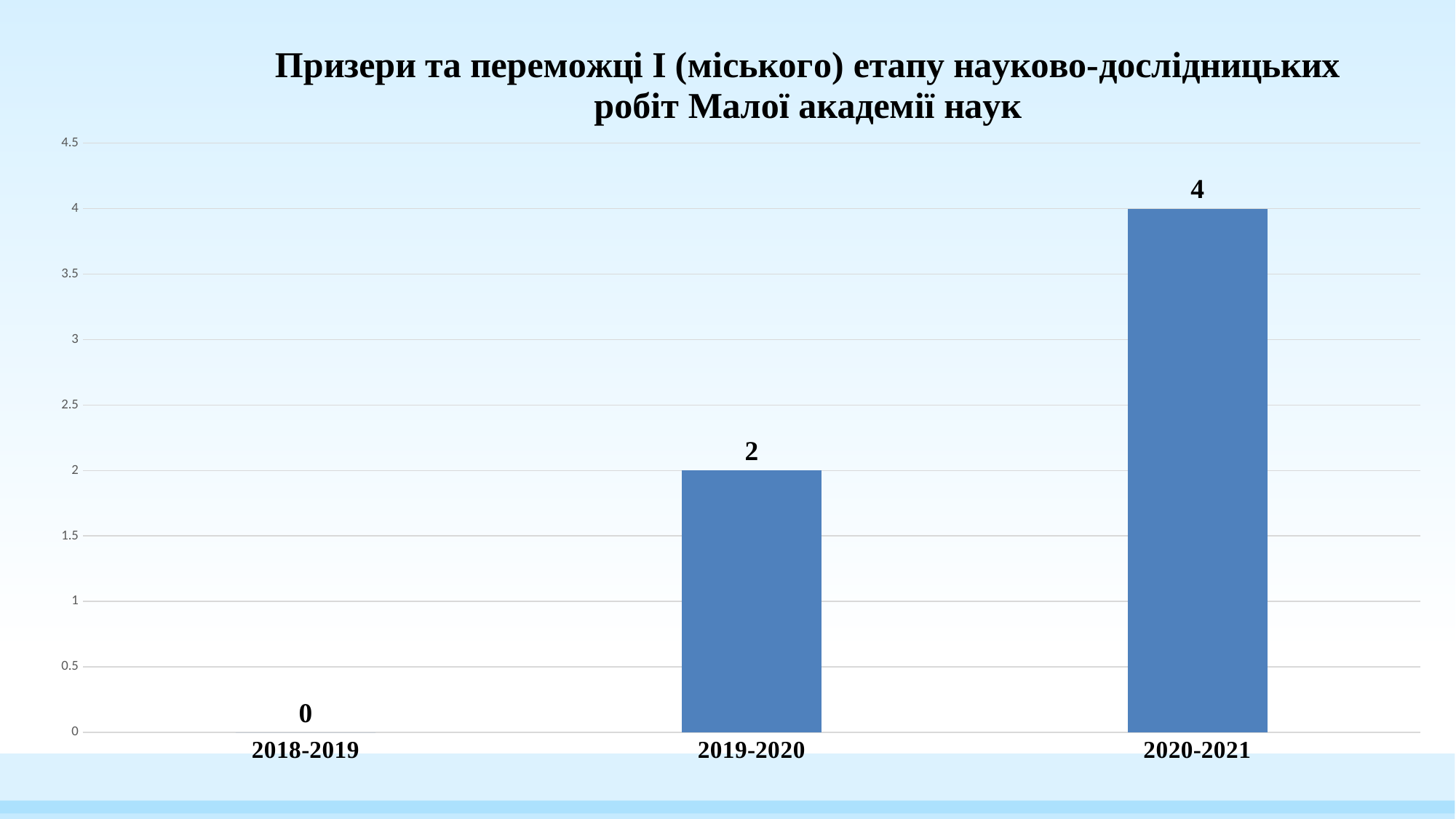
Which is larger, the value for 2019-2020 or the value for 2020-2021? 2020-2021 What is the value for 2019-2020? 2 Is the value for 2020-2021 greater or less than 3? greater Do the values rise or fall from 2018-2019 to 2020-2021? rise How many categories are shown on the x axis? 3 What is the value for 2020-2021? 4 Which year has the lowest value? 2018-2019 Which year has the highest value? 2020-2021 What is the value for 2018-2019? 0 What kind of chart is shown on the slide? bar chart What is the difference between the values for 2020-2021 and 2019-2020? 2 What is the highest value shown on the vertical axis? 4.5